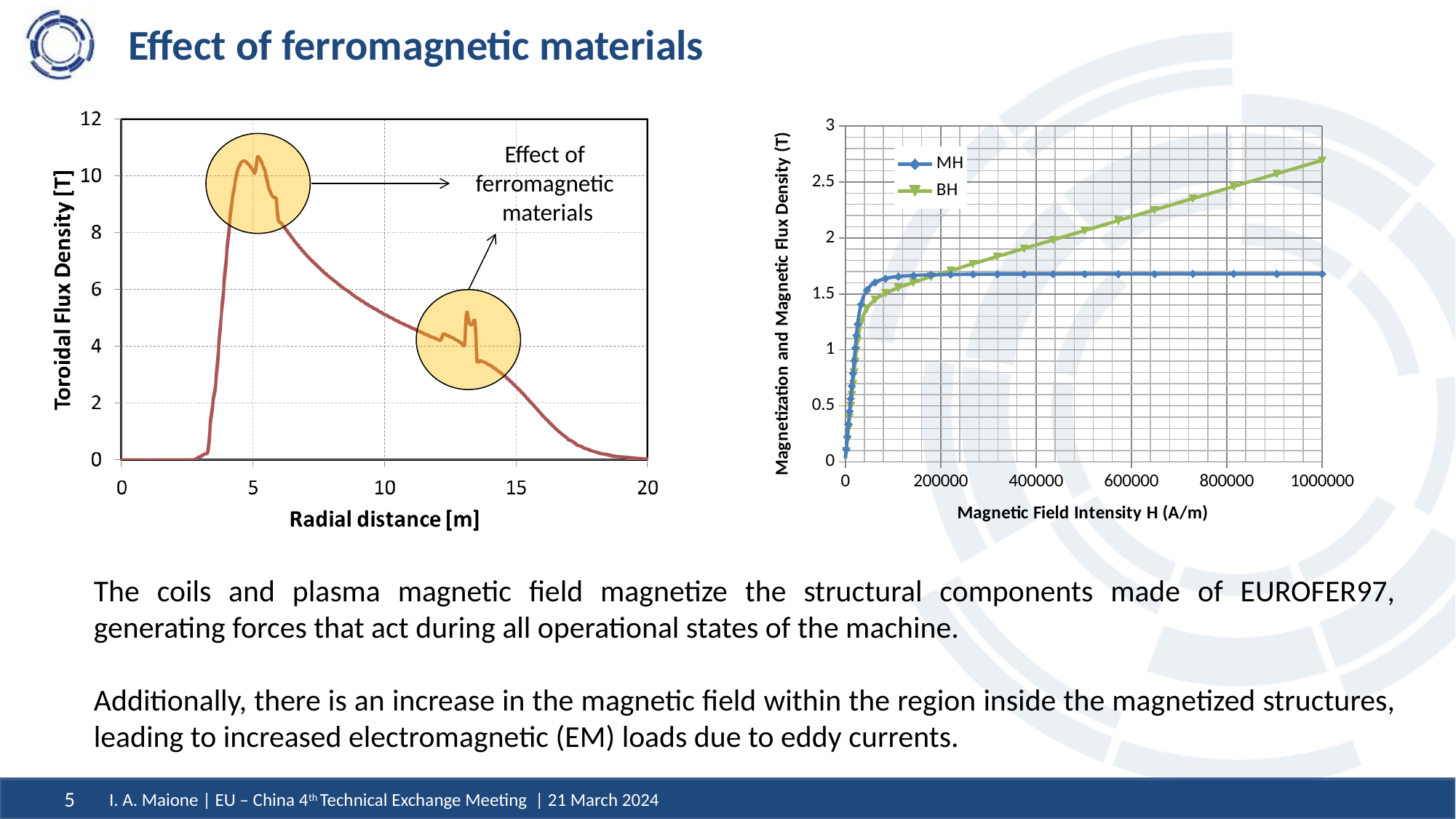
In the left chart (Toroidal Flux Density vs Radial distance), is the peak value of the curve greater or less than 10? greater In the left chart (Toroidal Flux Density vs Radial distance), is the value at a radial distance of 17.5 m greater or less than 2? less In the right chart (Magnetization and Magnetic Flux Density vs Magnetic Field Intensity), which series has the larger value at H = 1000000 A/m, MH or BH? BH What is the x-axis title of the right chart? Magnetic Field Intensity H (A/m) What kind of chart is the left chart showing Toroidal Flux Density against Radial distance? line chart In the right chart (Magnetization and Magnetic Flux Density vs Magnetic Field Intensity), does the BH series rise or fall as H increases from 200000 to 1000000 A/m? rise In the right chart (Magnetization and Magnetic Flux Density vs Magnetic Field Intensity), is the BH value at H = 1000000 A/m greater or less than 2.5? greater How many series does the legend of the right chart (Magnetization and Magnetic Flux Density vs Magnetic Field Intensity) list? 2 What are the two series named in the legend of the right chart (Magnetization and Magnetic Flux Density vs Magnetic Field Intensity)? MH and BH In the left chart (Toroidal Flux Density vs Radial distance), does the curve rise or fall between 7.5 m and 10 m? fall